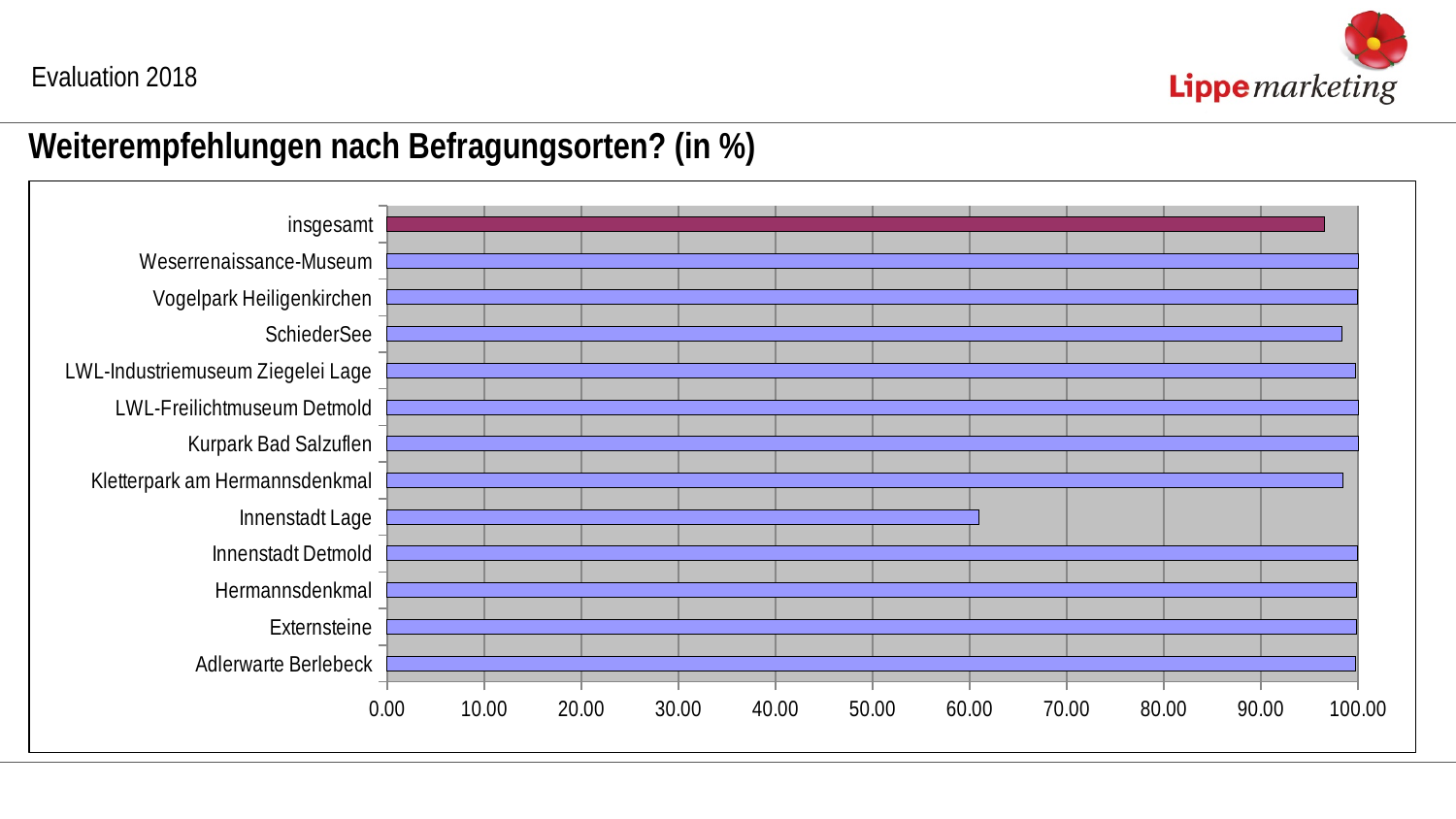
Is the value for Innenstadt Lage greater or less than 70.00? less What is the highest value shown on the x axis? 100.00 What is the title of the chart? Weiterempfehlungen nach Befragungsorten? (in %) What kind of chart is shown on the slide? bar chart Is the value for SchiederSee greater or less than 90.00? greater Is the value for Kletterpark am Hermannsdenkmal greater or less than 80.00? greater Which is larger, the value for Innenstadt Lage or the value for Innenstadt Detmold? Innenstadt Detmold Which is larger, the value for Innenstadt Lage or the value for insgesamt? insgesamt Which category has the lowest value? Innenstadt Lage Which category's bar is shown in a different colour from all the others? insgesamt How many categories are plotted in the chart? 13